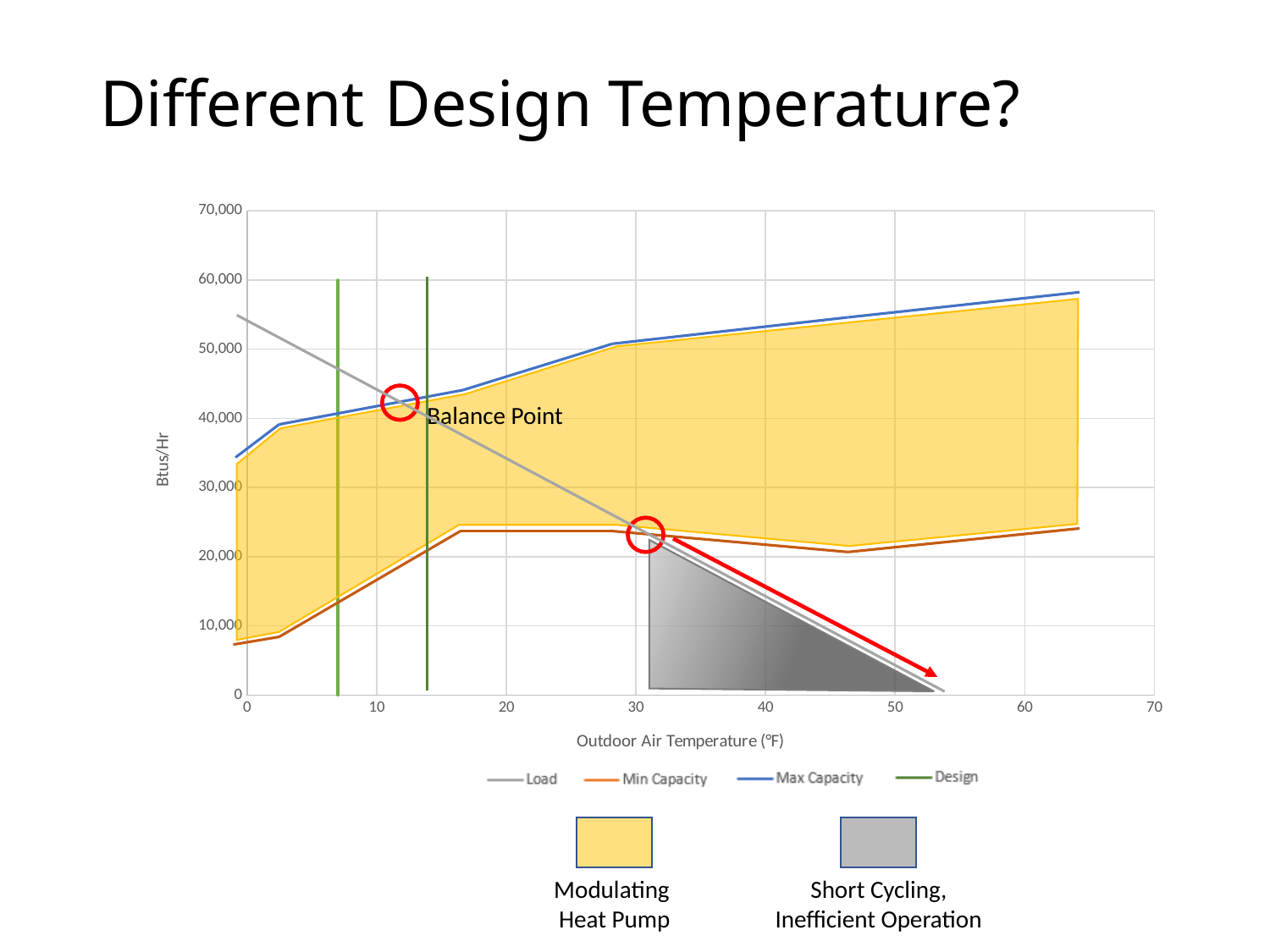
How many series does the chart legend list? 4 Does the Load line rise or fall as outdoor air temperature increases? falls At 0°F, which is larger: Load or Max Capacity? Load Is the Min Capacity value at 0°F greater or less than 10,000? less Is the Max Capacity value at 0°F greater or less than 30,000? greater What is the title of the vertical axis? Btus/Hr What kind of chart is shown on the slide? line chart At 50°F, which is larger: Max Capacity or Load? Max Capacity Does the Max Capacity line rise or fall as outdoor air temperature increases? rises What label is written next to the circled intersection of the Load and Max Capacity lines? Balance Point Is the Load value at 0°F greater or less than 50,000? greater